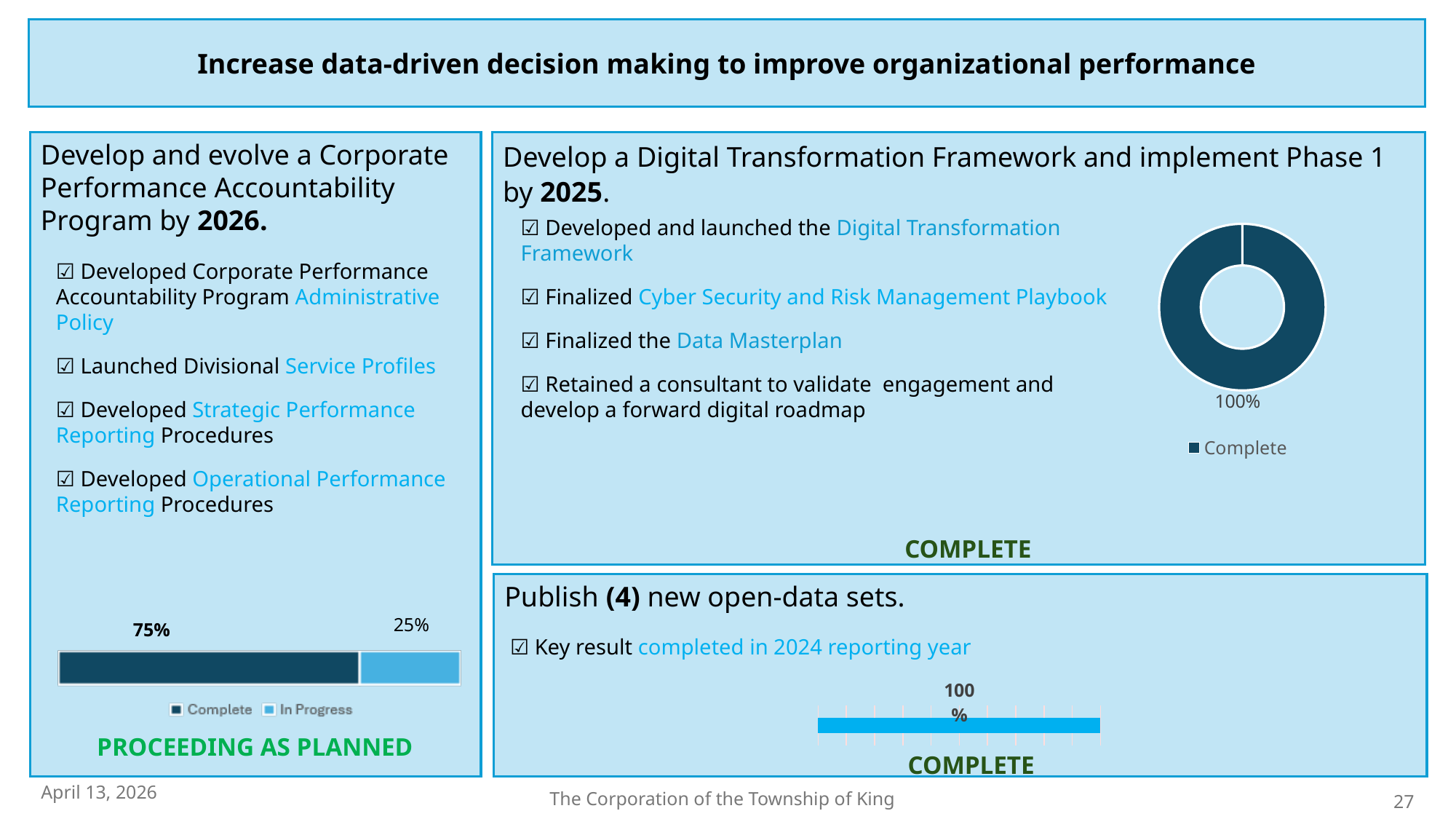
What kind of chart is shown in the top-right panel (Digital Transformation Framework)? Donut chart In the bar chart in the left panel, what is the total of the stacked bar? 100% In the bar chart in the bottom-right panel (Publish (4) new open-data sets), what value is labelled on the bar? 100% In the bar chart in the left panel, what is the difference between the Complete and In Progress values? 50% How many series does the legend of the bar chart in the left panel list? 2 What kind of chart is shown in the left panel (Corporate Performance Accountability Program)? Bar chart In the donut chart in the top-right panel, what is the value for Complete? 100% What are the legend entries of the bar chart in the left panel? Complete, In Progress In the bar chart in the left panel (Corporate Performance Accountability Program), what is the value for In Progress? 25% In the bar chart in the left panel (Corporate Performance Accountability Program), what is the value for Complete? 75% In the bar chart in the left panel, which series is larger, Complete or In Progress? Complete How many series does the legend of the donut chart in the top-right panel list? 1